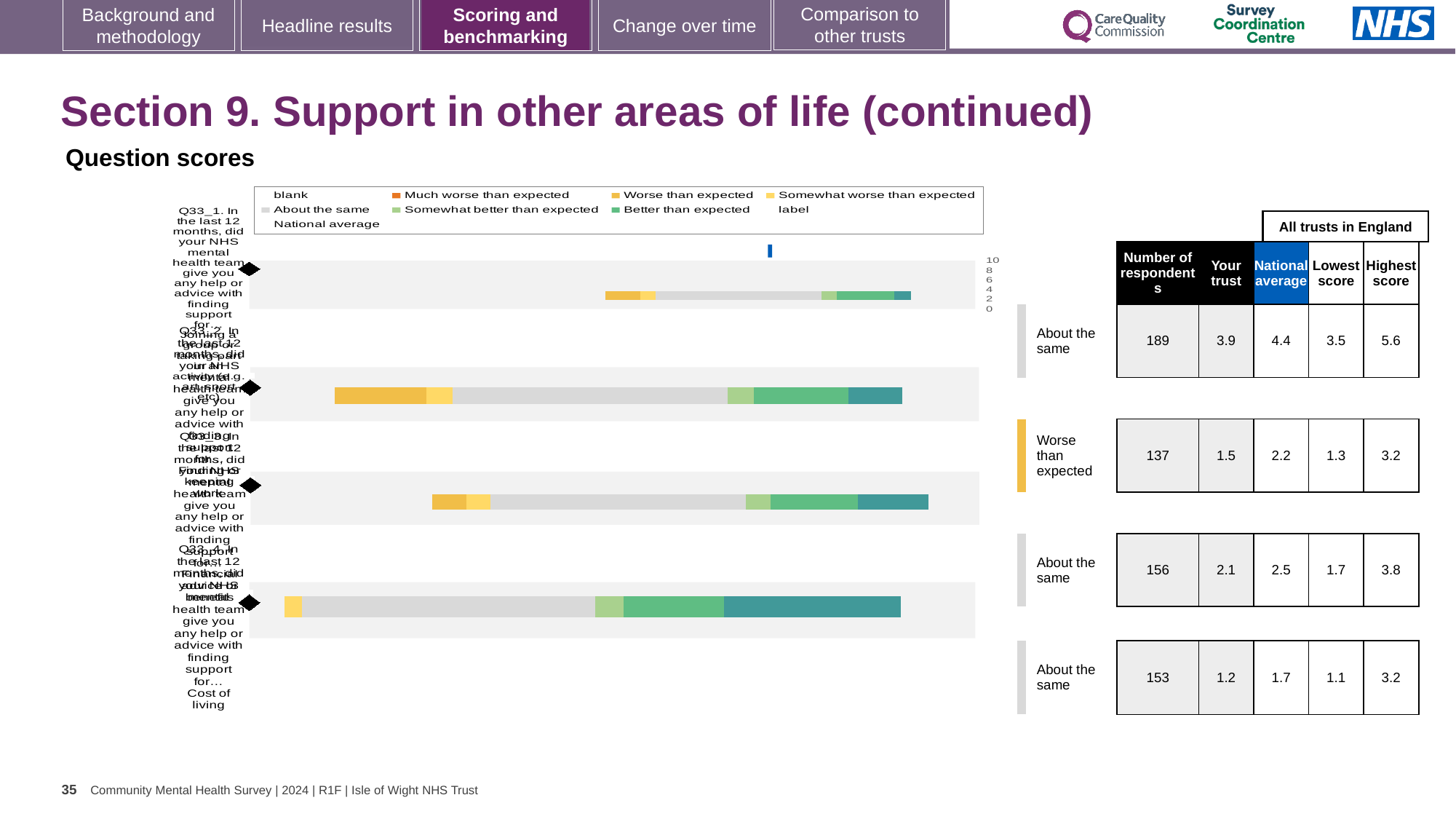
What kind of chart is shown under the heading 'Question scores'? bar chart What is the heading printed above the chart? Question scores How many question bars (Q33_1 to Q33_4) are plotted in the chart? 4 Which question row has the lowest 'Your trust' score in the table beside the chart? Q33_4 In the table beside the chart, what is the 'Your trust' score for the first row (Q33_1)? 3.9 In the table beside the chart, what is the number of respondents for the second row (Q33_2)? 137 In the table beside the chart, what is the highest score for the fourth row (Q33_4)? 3.2 Which question row is labelled 'Worse than expected' beside the chart? Q33_2 For the second row (Q33_2), which is larger: the 'Your trust' score or the national average? National average In the table beside the chart, what is the national average for the third row (Q33_3)? 2.5 Which question row has the highest 'Your trust' score in the table beside the chart? Q33_1 For the first row (Q33_1), what is the difference between the national average and the 'Your trust' score? 0.5